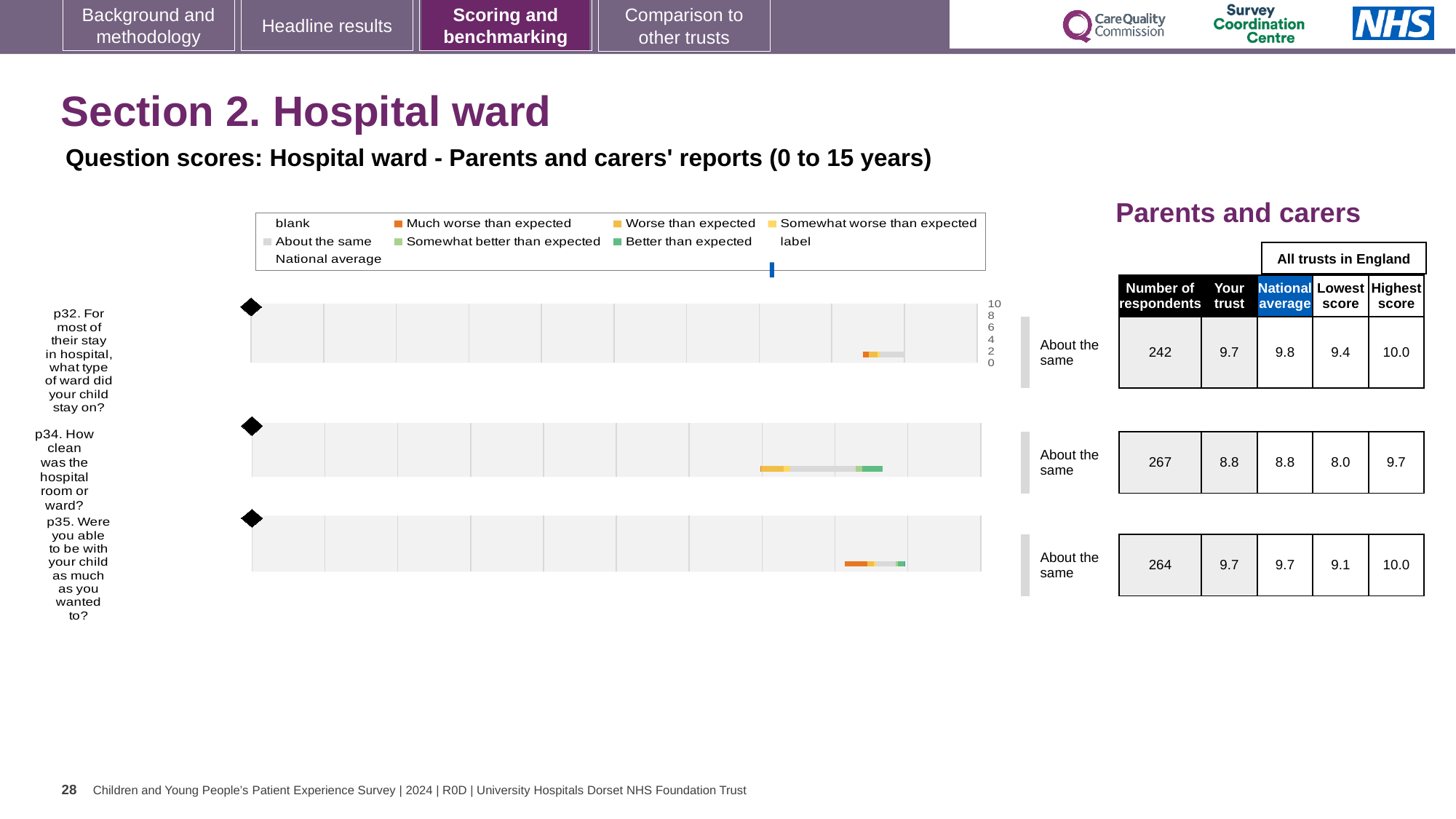
How many question charts are shown on the slide? 3 Which question has the highest number of respondents? p34 For p34, what is the difference between the highest score and the lowest score across all trusts in England? 1.7 How many respondents are listed for p32 (what type of ward did your child stay on)? 242 What is the national average for p35? 9.7 What benchmark category is shown for p35 (Were you able to be with your child as much as you wanted to)? About the same For p32, which is larger: the 'Your trust' score or the national average? National average What kind of chart is used for each question on the slide? bar chart What is the lowest score across all trusts in England for p32? 9.4 In the legend, what colour represents 'Much worse than expected'? orange Which question has the lowest 'Your trust' score? p34 What is the 'Your trust' score for p34 (How clean was the hospital room or ward)? 8.8